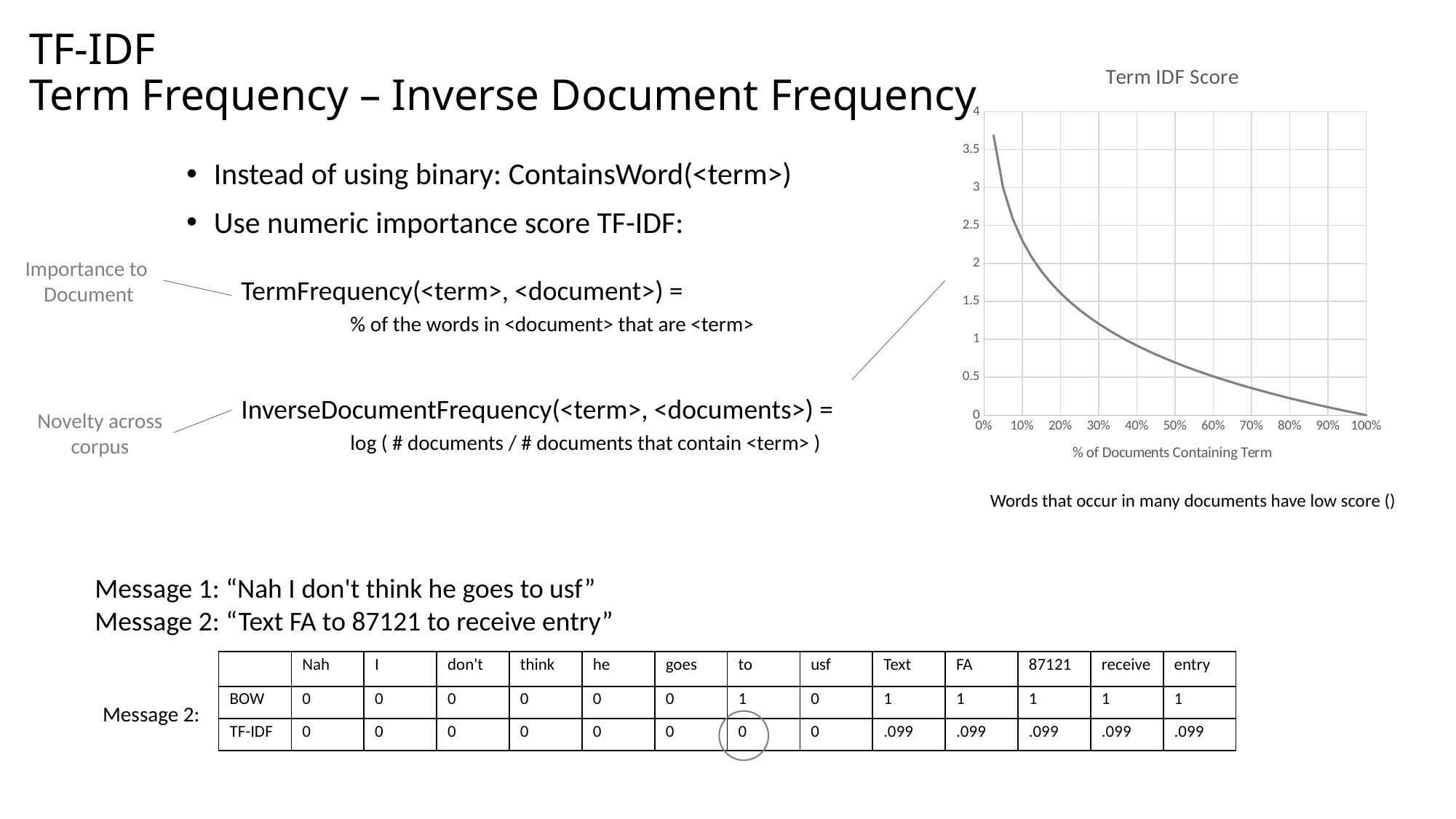
What is the title of the chart on the slide? Term IDF Score In the Term IDF Score chart, what is the IDF score when 100% of documents contain the term? 0 In the Term IDF Score chart, is the value at 30% greater or less than 1? greater In the Term IDF Score chart, is the value at 20% greater or less than 1? greater In the Term IDF Score chart, is the value at 90% greater or less than 0.5? less In the Term IDF Score chart, do the values rise or fall as the % of documents containing the term increases? fall What kind of chart is the Term IDF Score chart? line chart In the Term IDF Score chart, which is larger: the value at 10% or the value at 60%? the value at 10% What is the x-axis label of the Term IDF Score chart? % of Documents Containing Term